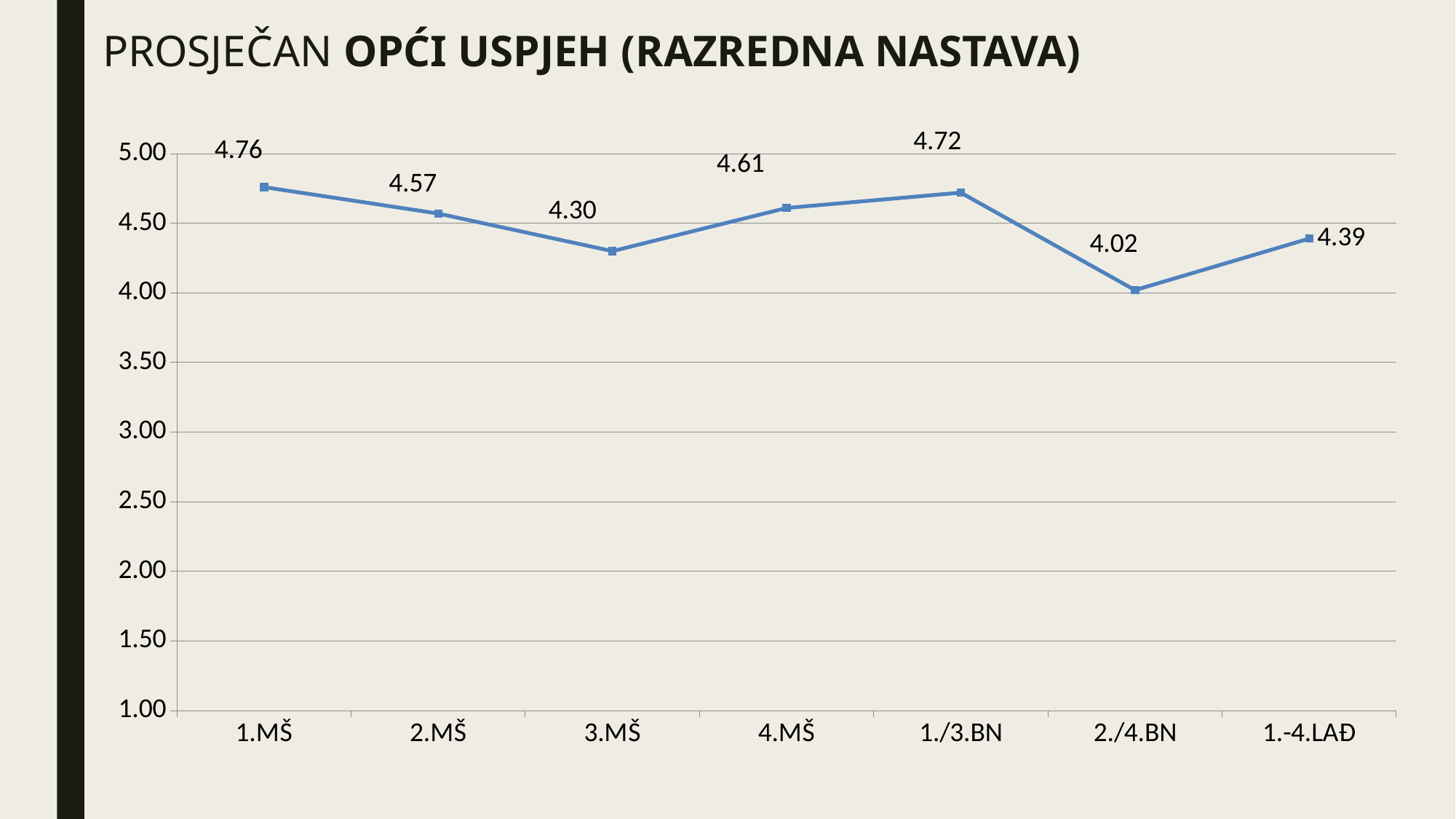
What is the value for 3.MŠ? 4.30 What is the title of the chart? PROSJEČAN OPĆI USPJEH (RAZREDNA NASTAVA) What is the difference between the values for 1.MŠ and 2./4.BN? 0.74 What is the value for 1.MŠ? 4.76 What kind of chart is this? line chart Which is larger, the value for 4.MŠ or the value for 2.MŠ? 4.MŠ Which category has the lowest value? 2./4.BN How many categories are shown on the x axis? 7 What is the value for 1.-4.LAĐ? 4.39 Which category has the highest value? 1.MŠ What is the value for 2./4.BN? 4.02 Is the value for 1./3.BN greater or less than 4.50? greater